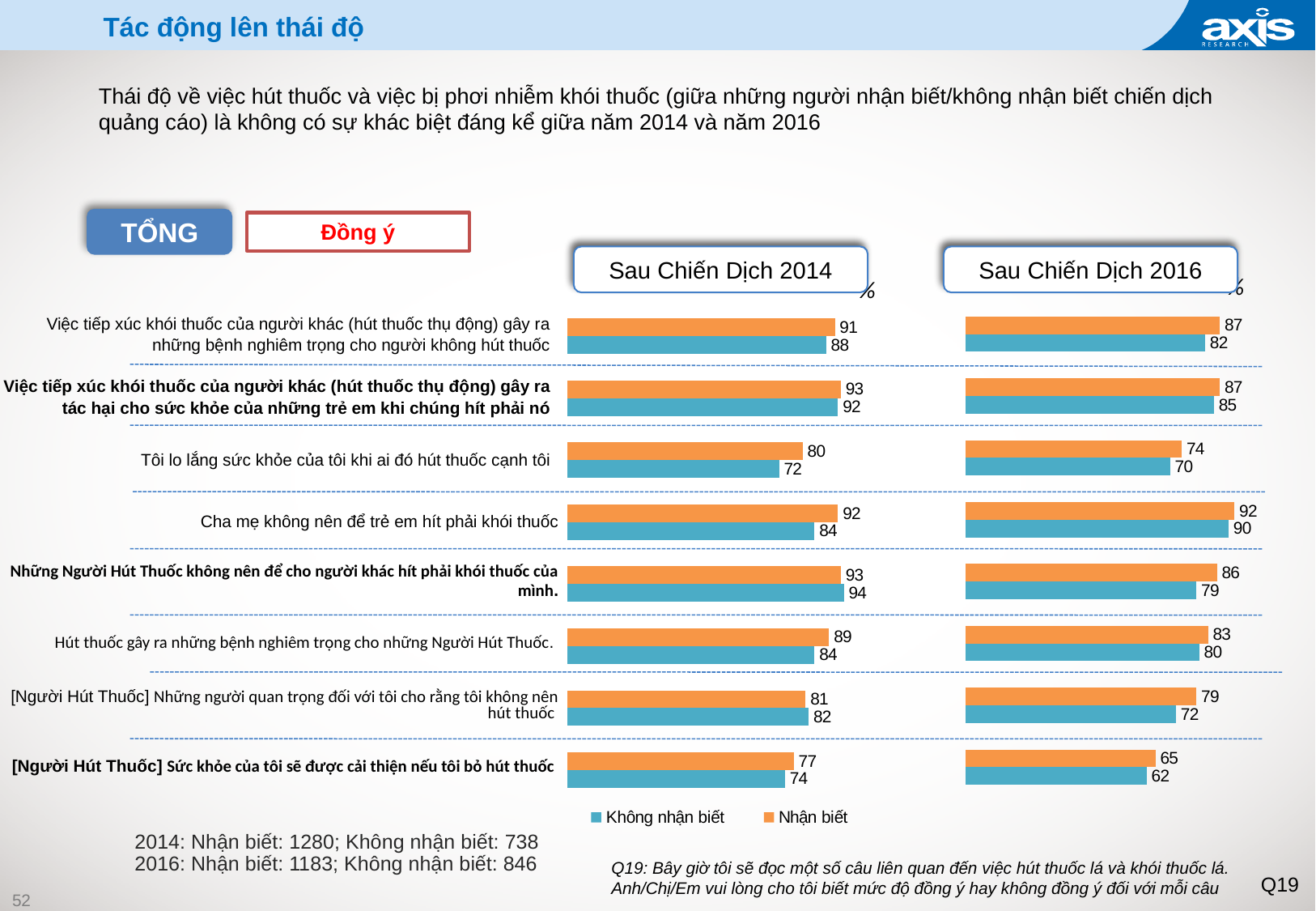
In the 'Sau Chiến Dịch 2016' chart, what is the difference between 'Nhận biết' and 'Không nhận biết' for 'Những Người Hút Thuốc không nên để cho người khác hít phải khói thuốc của mình.'? 7 In the 'Sau Chiến Dịch 2014' chart, what is the value for 'Nhận biết' on 'Tôi lo lắng sức khỏe của tôi khi ai đó hút thuốc cạnh tôi'? 80 How many categories are shown in the 'Sau Chiến Dịch 2014' chart? 8 How many series does the legend list for the charts on this slide? 2 In the 'Sau Chiến Dịch 2016' chart, what is the value for 'Nhận biết' on '[Người Hút Thuốc] Sức khỏe của tôi sẽ được cải thiện nếu tôi bỏ hút thuốc'? 65 In the 'Sau Chiến Dịch 2016' chart, what is the value for 'Không nhận biết' on 'Cha mẹ không nên để trẻ em hít phải khói thuốc'? 90 In the 'Sau Chiến Dịch 2016' chart, which category has the highest 'Nhận biết' value? Cha mẹ không nên để trẻ em hít phải khói thuốc In the 'Sau Chiến Dịch 2014' chart, which category has the lowest 'Không nhận biết' value? Tôi lo lắng sức khỏe của tôi khi ai đó hút thuốc cạnh tôi In the 'Sau Chiến Dịch 2014' chart, which is larger for 'Những Người Hút Thuốc không nên để cho người khác hít phải khói thuốc của mình.': 'Nhận biết' or 'Không nhận biết'? Không nhận biết What type of chart is the 'Sau Chiến Dịch 2016' chart? Bar chart In the 'Sau Chiến Dịch 2016' chart, which is larger for '[Người Hút Thuốc] Những người quan trọng đối với tôi cho rằng tôi không nên hút thuốc': 'Nhận biết' or 'Không nhận biết'? Nhận biết In the 'Sau Chiến Dịch 2014' chart, what is the difference between 'Nhận biết' and 'Không nhận biết' for 'Cha mẹ không nên để trẻ em hít phải khói thuốc'? 8